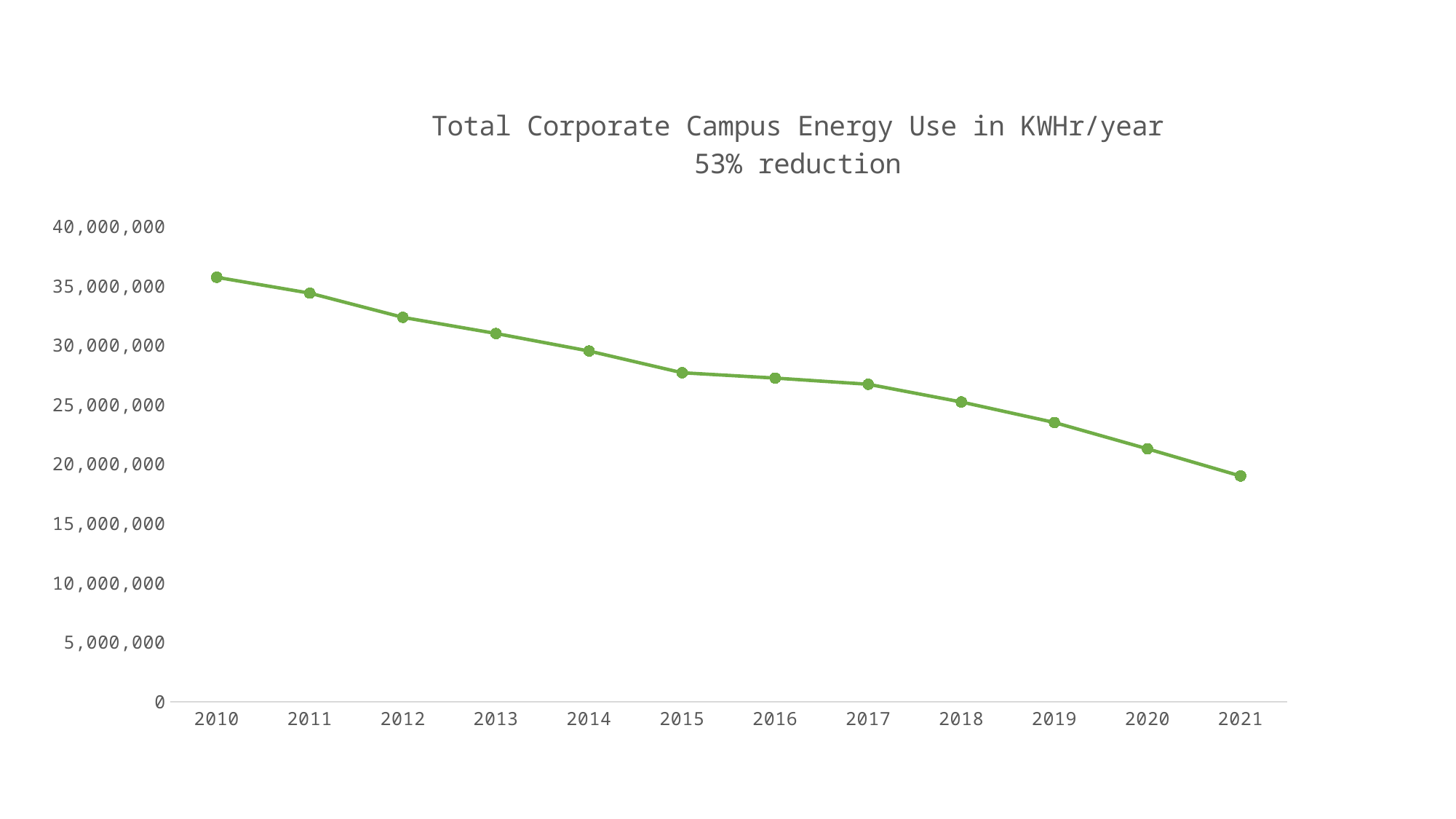
Do the values rise or fall from 2010 to 2021? fall Which is larger, the value for 2012 or the value for 2019? 2012 Is the value for 2010 greater or less than 35,000,000? greater Which year has the highest energy use? 2010 What kind of chart is shown on the slide? line chart Which year has the lowest energy use? 2021 How many years are plotted on the x axis? 12 Is the value for 2015 greater or less than 30,000,000? less Is the value for 2021 greater or less than 20,000,000? less What is the title of the chart? Total Corporate Campus Energy Use in KWHr/year 53% reduction What percentage reduction does the chart title state? 53%